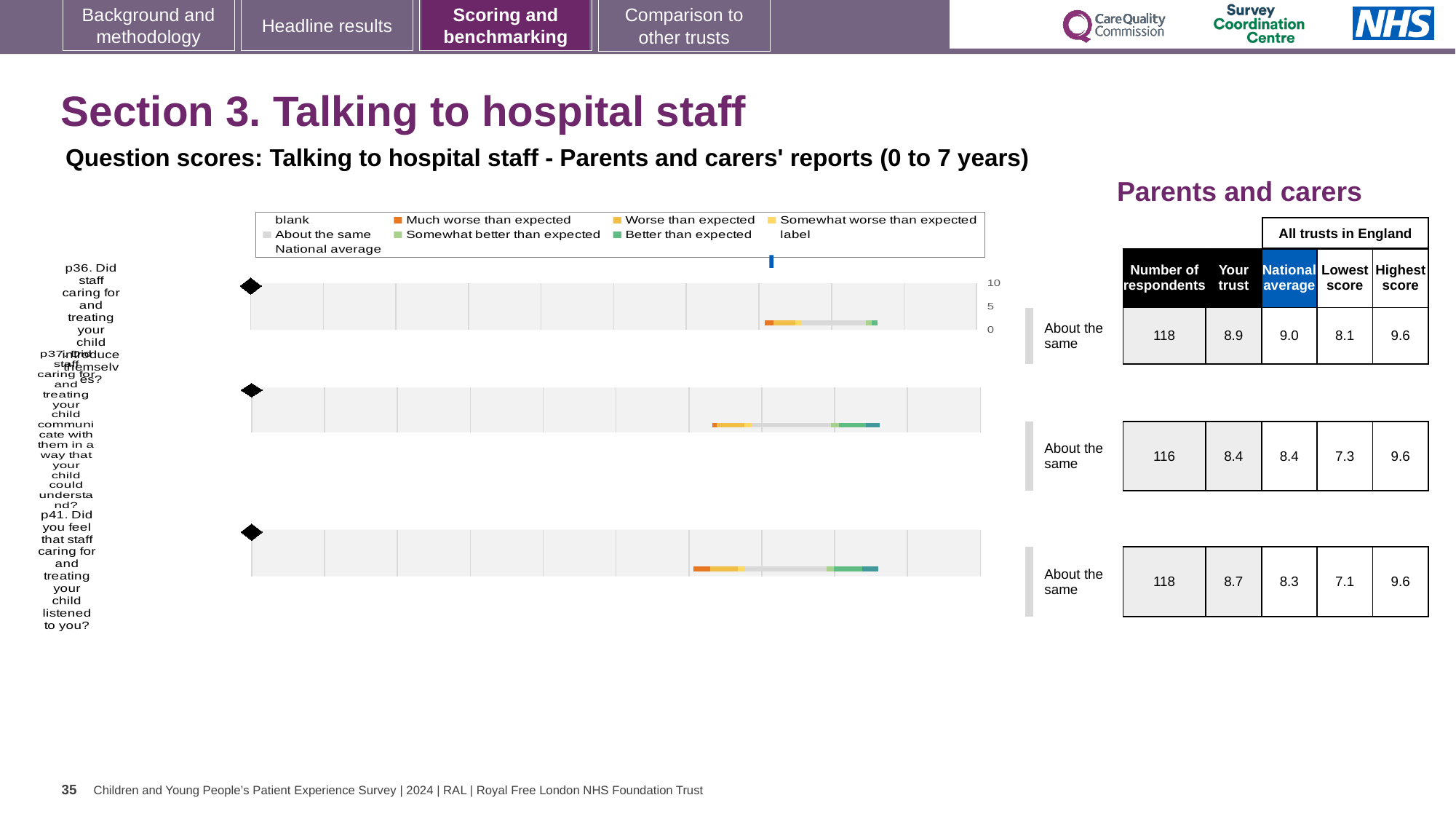
Which question has the lowest 'Lowest score' among all trusts in England? p41 In the chart legend, what colour represents 'Much worse than expected'? orange What kind of chart is used to show the benchmark results for each question? bar chart How many separate benchmark charts are plotted on the slide? 3 What is the 'Your trust' score for p36 (Did staff caring for and treating your child introduce themselves?)? 8.9 For p36, which is larger: the 'Your trust' score or the national average? National average What is the highest value shown on the score axis of the benchmark charts? 10 What is the highest score across all trusts in England for p41 (Did you feel that staff listened to you?)? 9.6 Which question has the highest 'Your trust' score? p36 What is the difference between the 'Your trust' score and the national average for p41? 0.4 How many respondents answered p37? 116 What is the national average score for p37 (Did staff communicate with your child in a way they could understand?)? 8.4